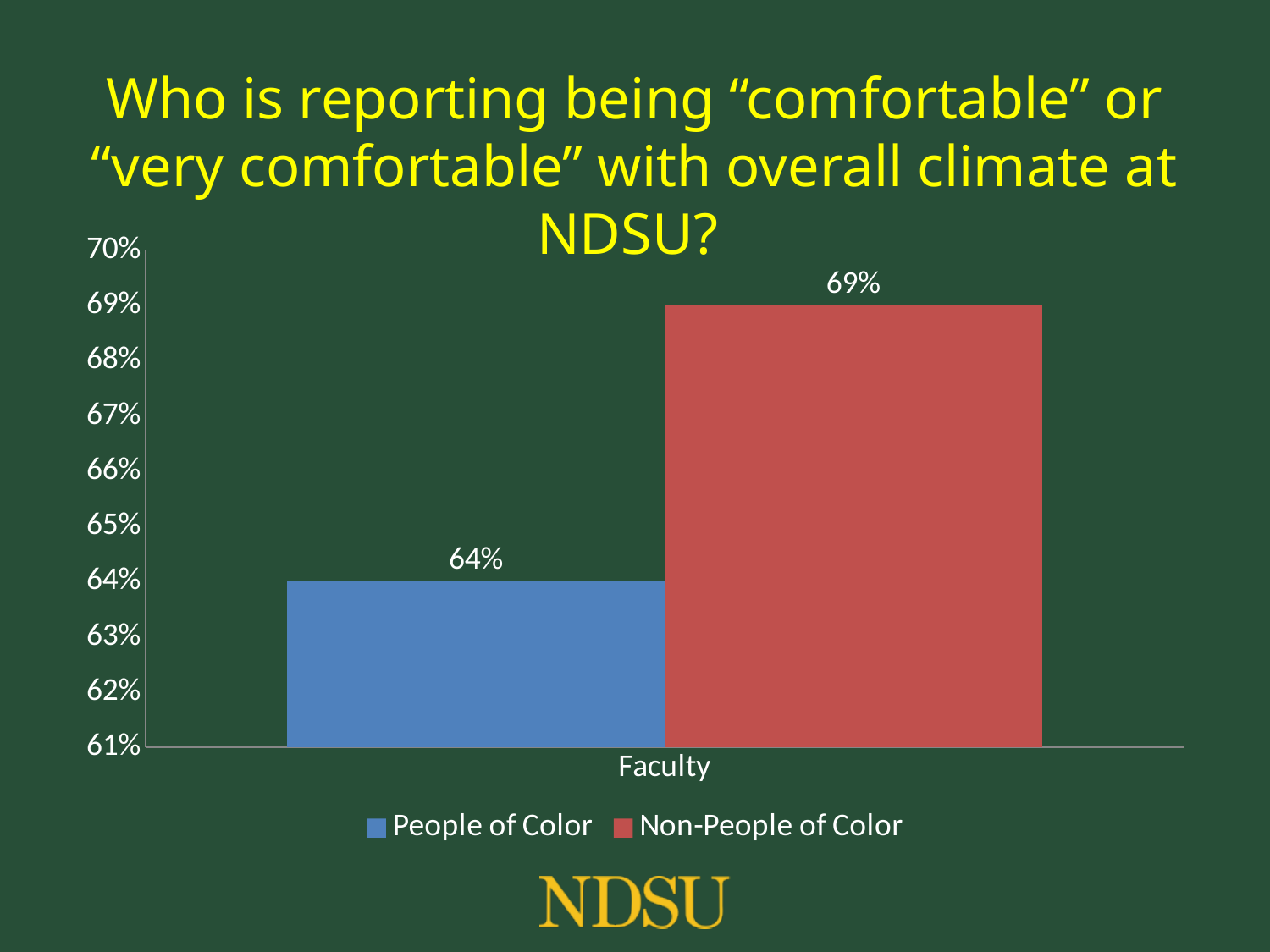
What colour is the bar for Non-People of Color? red How many categories are shown on the x axis? 1 Which series has the lower value for Faculty? People of Color Is the value for Non-People of Color greater or less than 68%? greater What percentage of People of Color faculty report being comfortable or very comfortable with the overall climate at NDSU? 64% Is the value for People of Color or Non-People of Color larger? Non-People of Color What is the difference between the Non-People of Color and People of Color values for Faculty? 5% How many series does the legend list? 2 What kind of chart is shown on the slide? bar chart What percentage of Non-People of Color faculty report being comfortable or very comfortable with the overall climate at NDSU? 69% Which series has the higher value for Faculty? Non-People of Color Is the value for People of Color greater or less than 65%? less